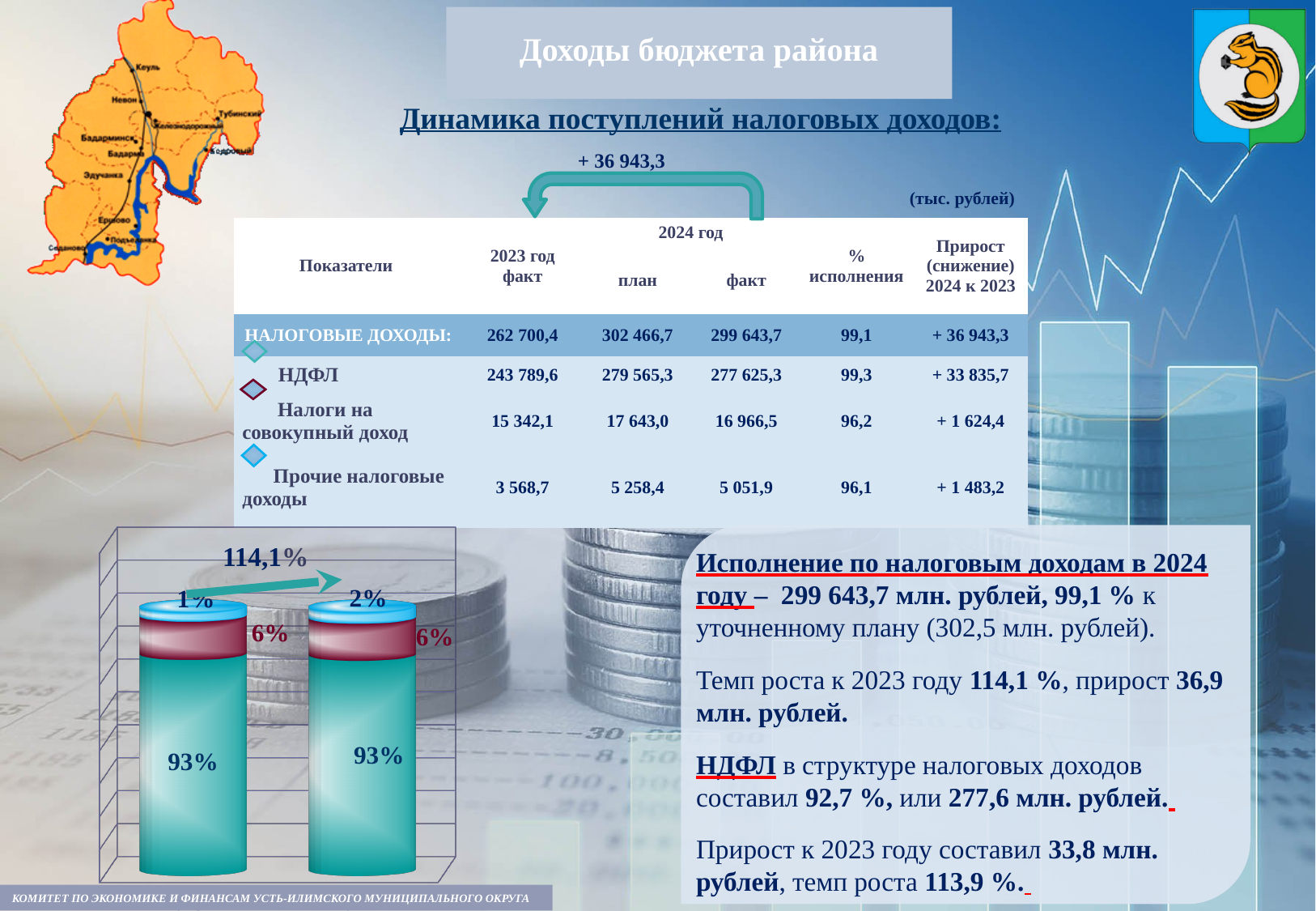
What kind of chart is shown at the bottom left of the slide? Stacked bar chart In the bottom-left chart, what is the difference between the top (blue) segment of the right bar and that of the left bar? 1% In the bottom-left chart, which bar has the larger top (blue) segment, the left or the right? Right How many segments does each bar in the bottom-left chart have? 3 How many bars does the chart at the bottom left of the slide show? 2 In the bottom-left chart, what is the value of the top (blue) segment of the right bar? 2% In the bottom-left chart, what is the value of the largest (teal) segment of the left bar? 93% In the bottom-left chart, which segment is the largest in each bar? The teal segment at 93% What percentage is printed on the arrow above the bars in the bottom-left chart? 114,1% In the bottom-left chart, what is the value of the dark red segment of the left bar? 6% In the bottom-left chart, what is the value of the top (blue) segment of the left bar? 1% In the bottom-left chart, what is the value of the largest (teal) segment of the right bar? 93%